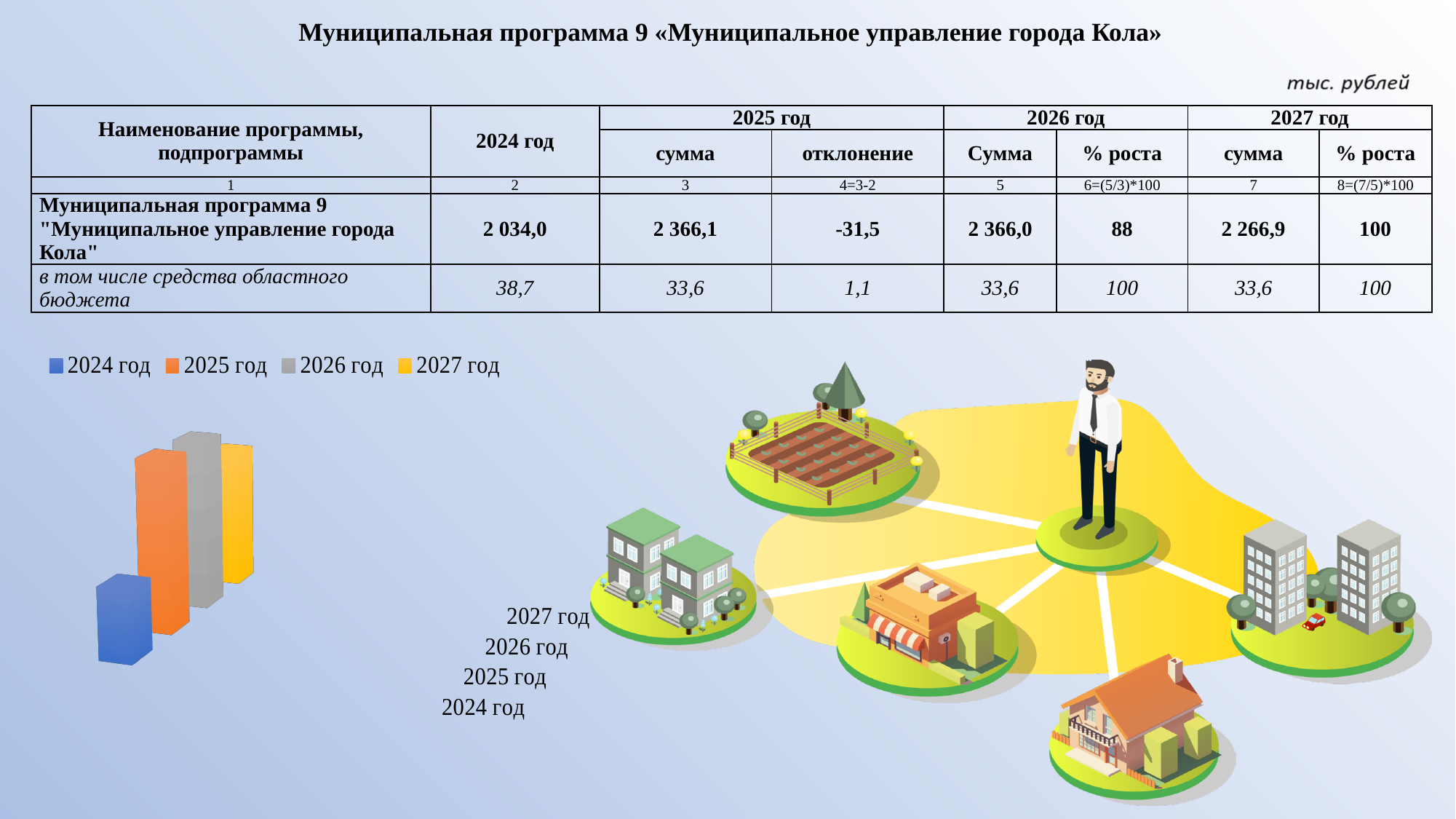
How many series does the chart legend list? 4 Which bar is taller in the chart, 2024 год or 2025 год? 2025 год Which year is shown in orange in the chart legend? 2025 год How many bars are plotted in the chart? 4 Which year has the lowest bar in the chart? 2024 год What colour is the bar for 2024 год in the chart? blue Which bar is taller in the chart, 2024 год or 2026 год? 2026 год What kind of chart is shown on the slide? bar chart Which bar is taller in the chart, 2024 год or 2027 год? 2027 год